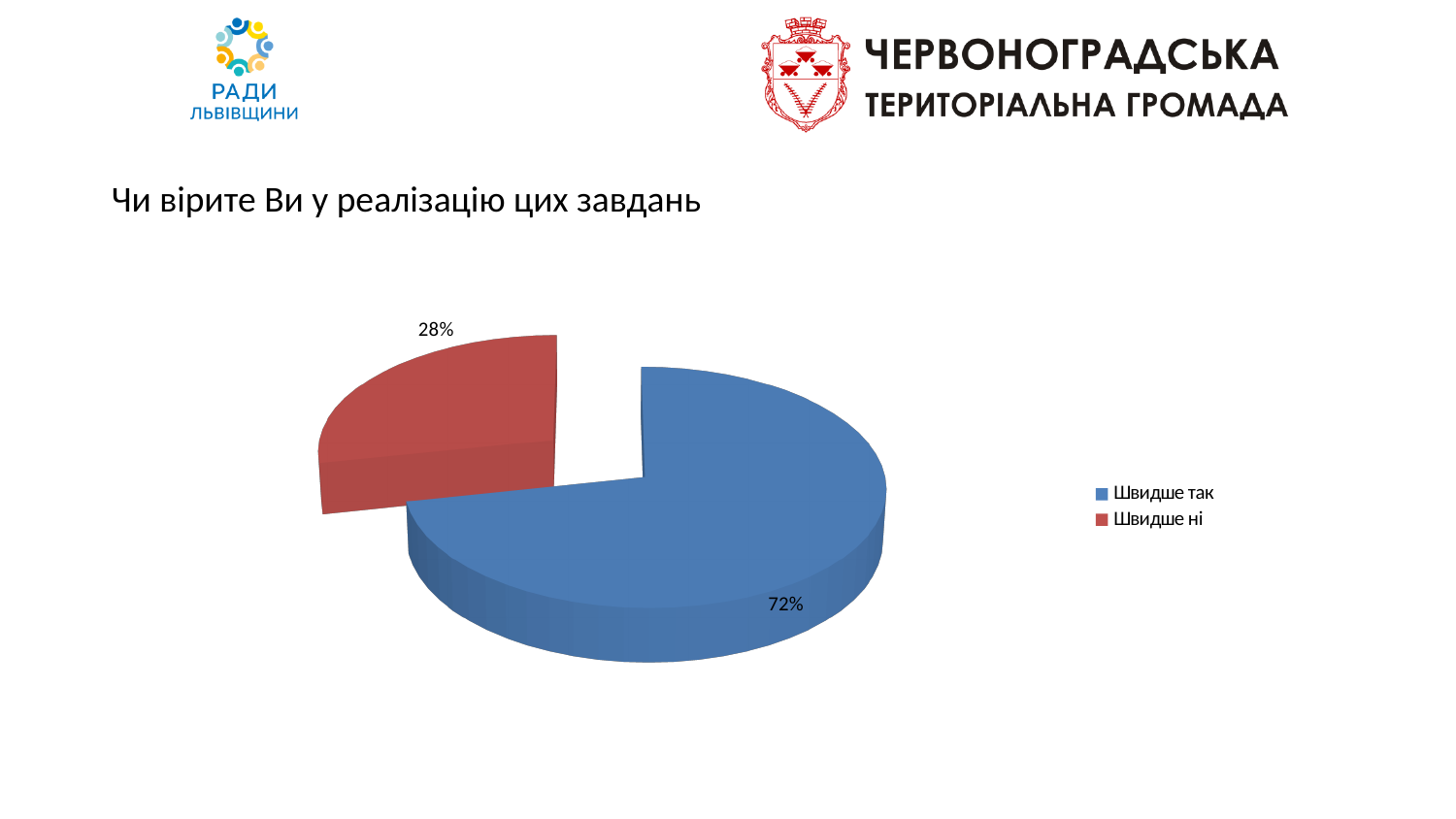
What is the difference in percentage points between "Швидше так" and "Швидше ні"? 44 What kind of chart is shown on the slide? pie chart Which category has the smallest slice of the pie? Швидше ні What question is the chart on the slide about? Чи вірите Ви у реалізацію цих завдань How many slices does the pie chart have? 2 Which category has the largest slice of the pie? Швидше так What share of the pie does "Швидше ні" represent? 28% How many entries does the legend list? 2 What colour is the slice for "Швидше ні"? red What share of the pie does "Швидше так" represent? 72% Which is larger, the share for "Швидше так" or for "Швидше ні"? Швидше так